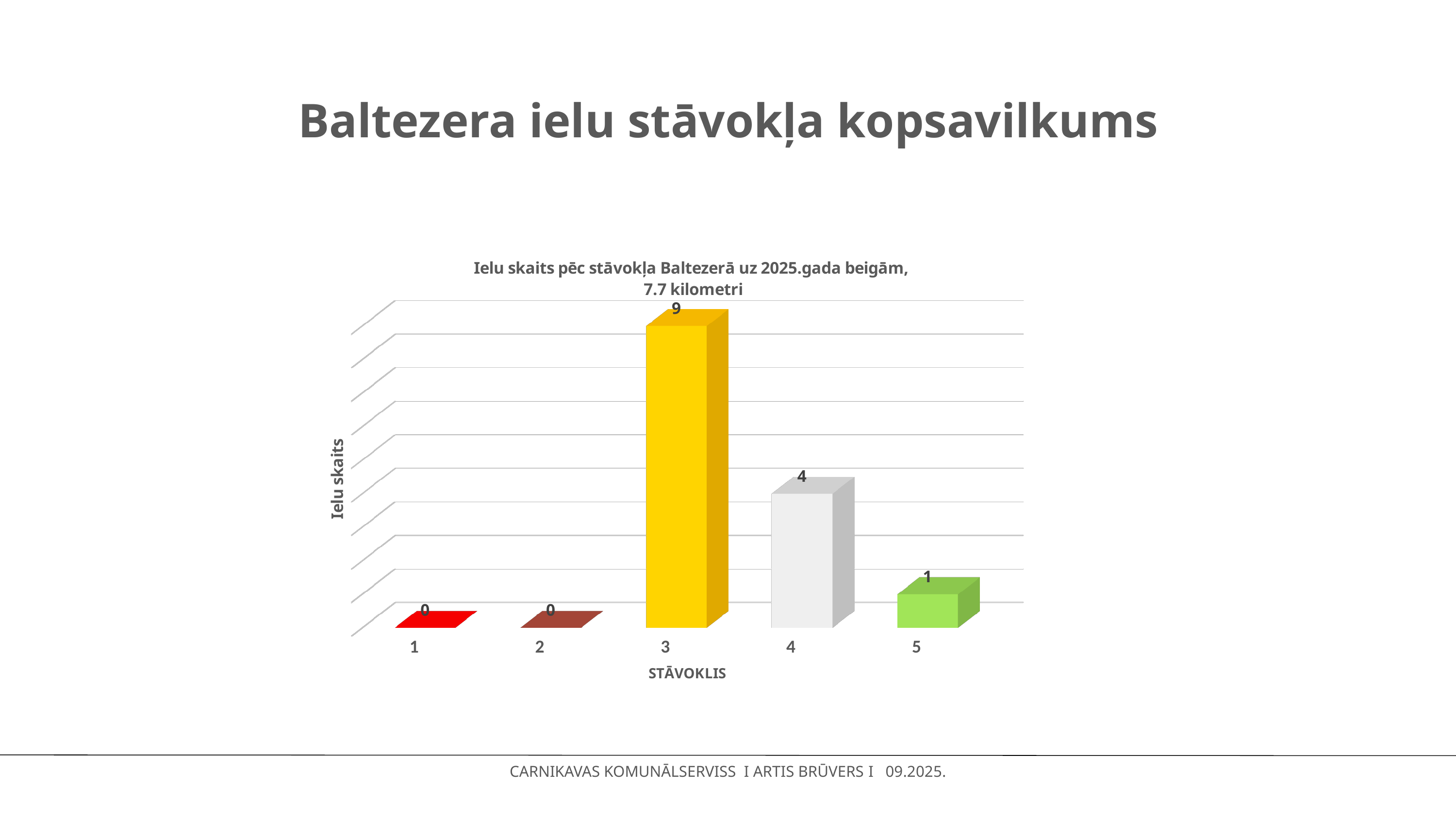
What is the value for category 1? 0 What is the difference between the values for category 3 and category 4? 5 Which category has the highest value? 3 What is the label of the x axis? STĀVOKLIS What is the difference between the values for category 4 and category 5? 3 What is the value for category 3? 9 What is the value for category 4? 4 Which is larger, the value for category 4 or the value for category 5? category 4 Which categories have the lowest value? 1 and 2 What is the value for category 5? 1 What kind of chart is shown on the slide? bar chart How many categories are shown on the x axis? 5